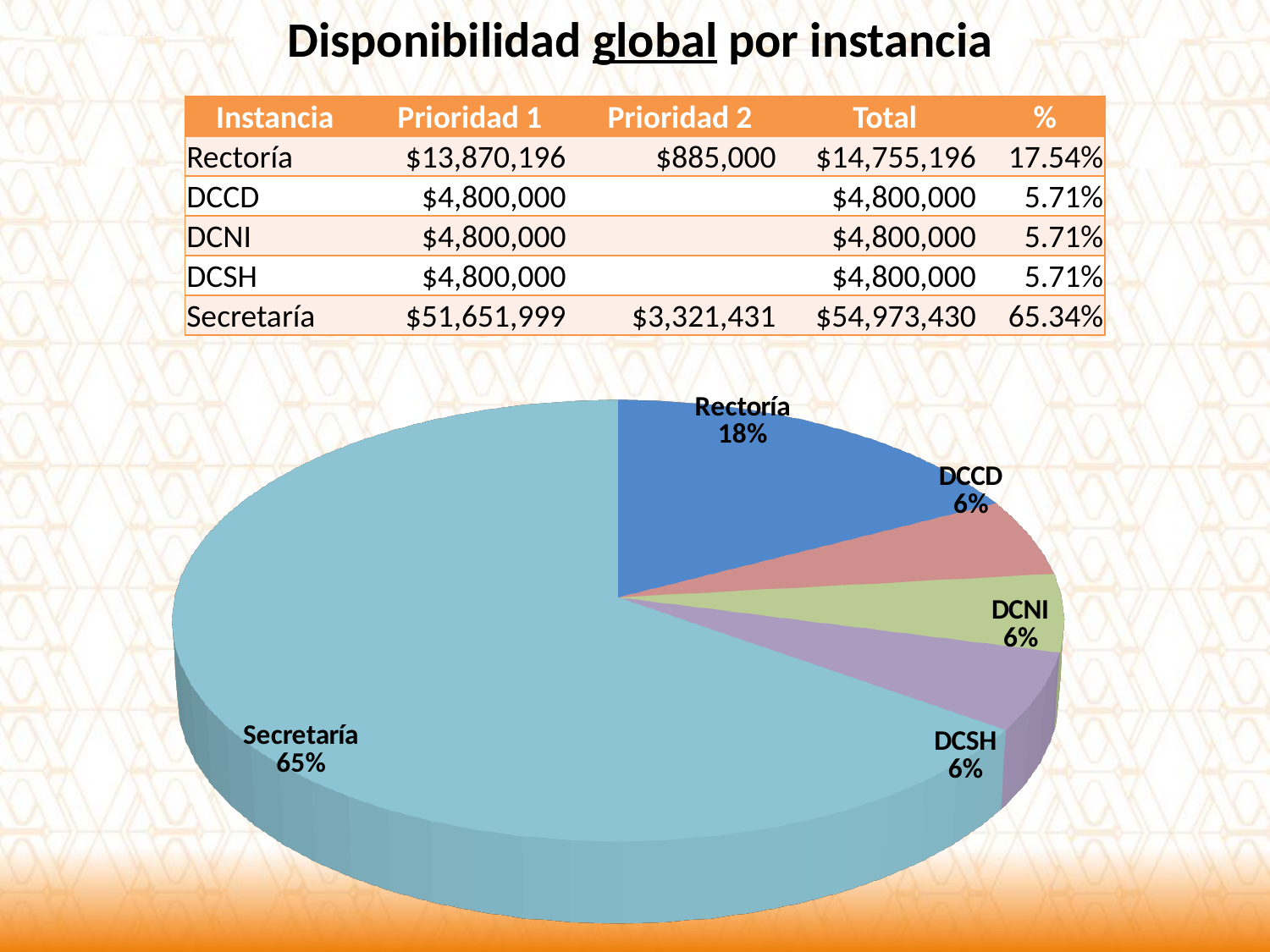
What is the difference in percentage points between the Secretaría slice and the Rectoría slice? 47 Which slice of the pie chart is the largest? Secretaría What colour is the Rectoría slice in the pie chart? blue How many slices does the pie chart have? 5 What share of the pie does DCCD have? 6% What share of the pie does Secretaría have? 65% What share of the pie does DCNI have? 6% What is the title of the slide containing the pie chart? Disponibilidad global por instancia Is the share for Secretaría greater or less than 50%? greater What kind of chart is shown on the slide? pie chart Which is larger in the pie chart, Rectoría or DCSH? Rectoría